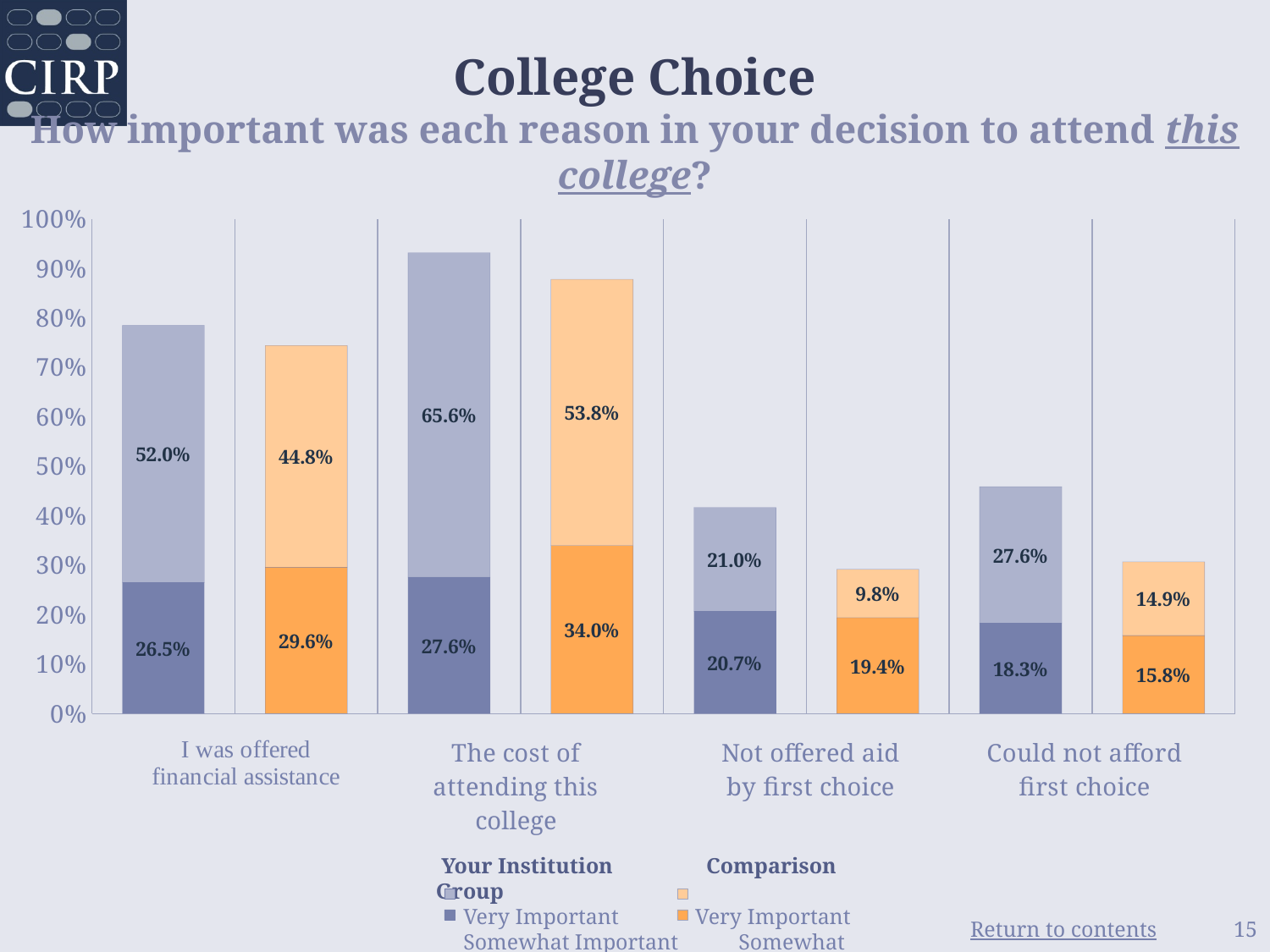
What is the Comparison Group's Very Important value for 'Could not afford first choice'? 15.8% How many series does the legend list? 4 What kind of chart is shown on the slide? Stacked bar chart What percentage of the Comparison Group rated 'I was offered financial assistance' as Somewhat Important? 44.8% Which reason has the lowest Somewhat Important value for the Comparison Group? Not offered aid by first choice What is the difference between the Comparison Group's and Your Institution's Very Important values for 'The cost of attending this college'? 6.4% Which is larger for 'Not offered aid by first choice': Your Institution's Somewhat Important value or the Comparison Group's Somewhat Important value? Your Institution What is the total (Very Important plus Somewhat Important) for the Comparison Group on 'Could not afford first choice'? 30.7% How many reasons (categories) are shown along the x axis? 4 What is the total (Very Important plus Somewhat Important) for Your Institution on 'I was offered financial assistance'? 78.5% What percentage of Your Institution respondents rated 'The cost of attending this college' as Very Important? 27.6% Which reason has the highest Very Important value for the Comparison Group? The cost of attending this college